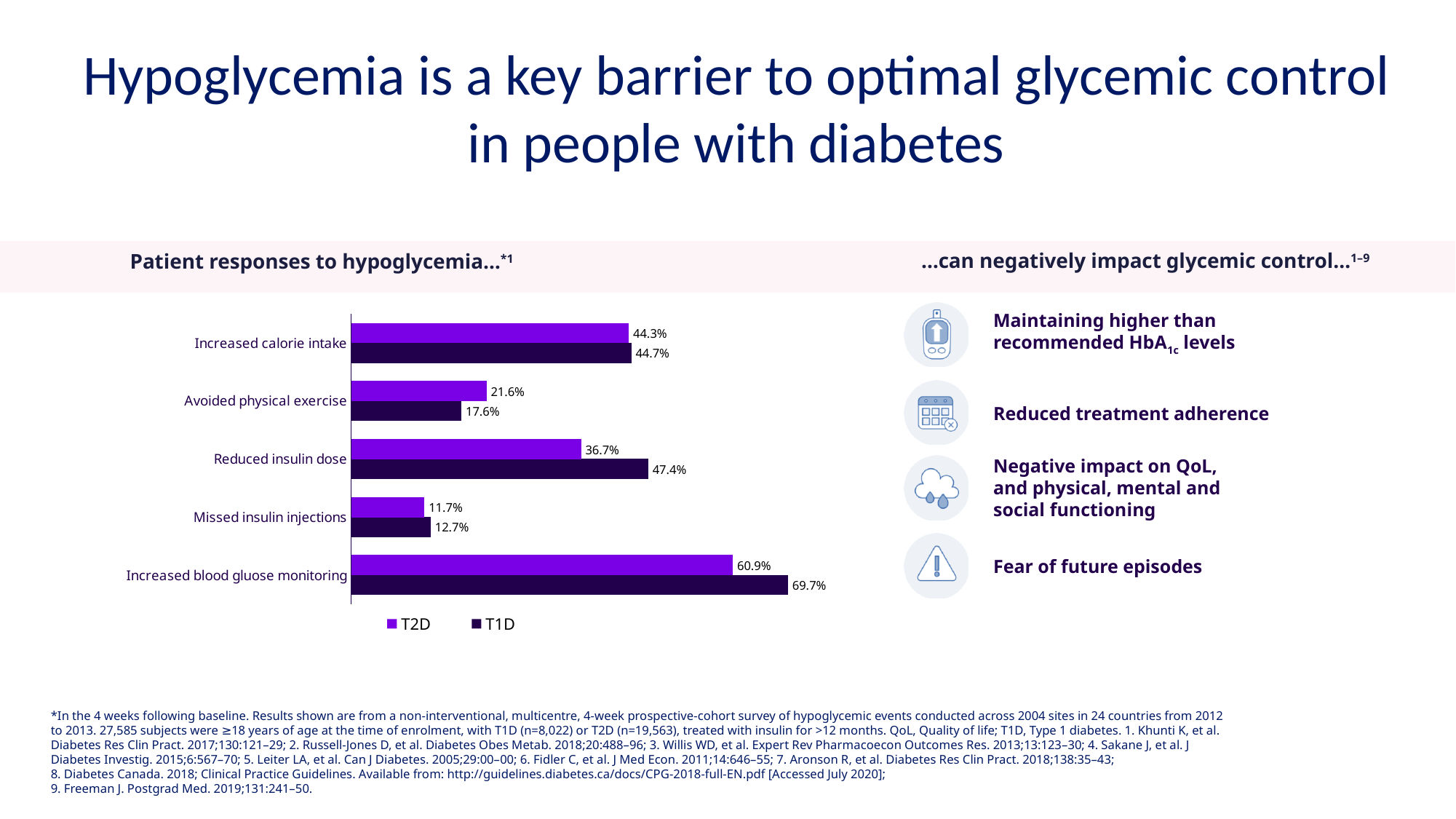
How many series does the legend list? 2 What are the two series named in the chart legend? T2D and T1D For Avoided physical exercise, which is larger: the T2D value or the T1D value? T2D Which category has the lowest T2D value? Missed insulin injections Which category has the highest T1D value? Increased blood gluose monitoring What is the T2D value for Increased calorie intake? 44.3% What is the T2D value for Missed insulin injections? 11.7% What is the difference between the T1D and T2D values for Reduced insulin dose? 10.7% What kind of chart is shown on the slide? Bar chart How many categories are shown in the bar chart? 5 What is the T1D value for Increased blood gluose monitoring? 69.7% What is the T1D value for Reduced insulin dose? 47.4%